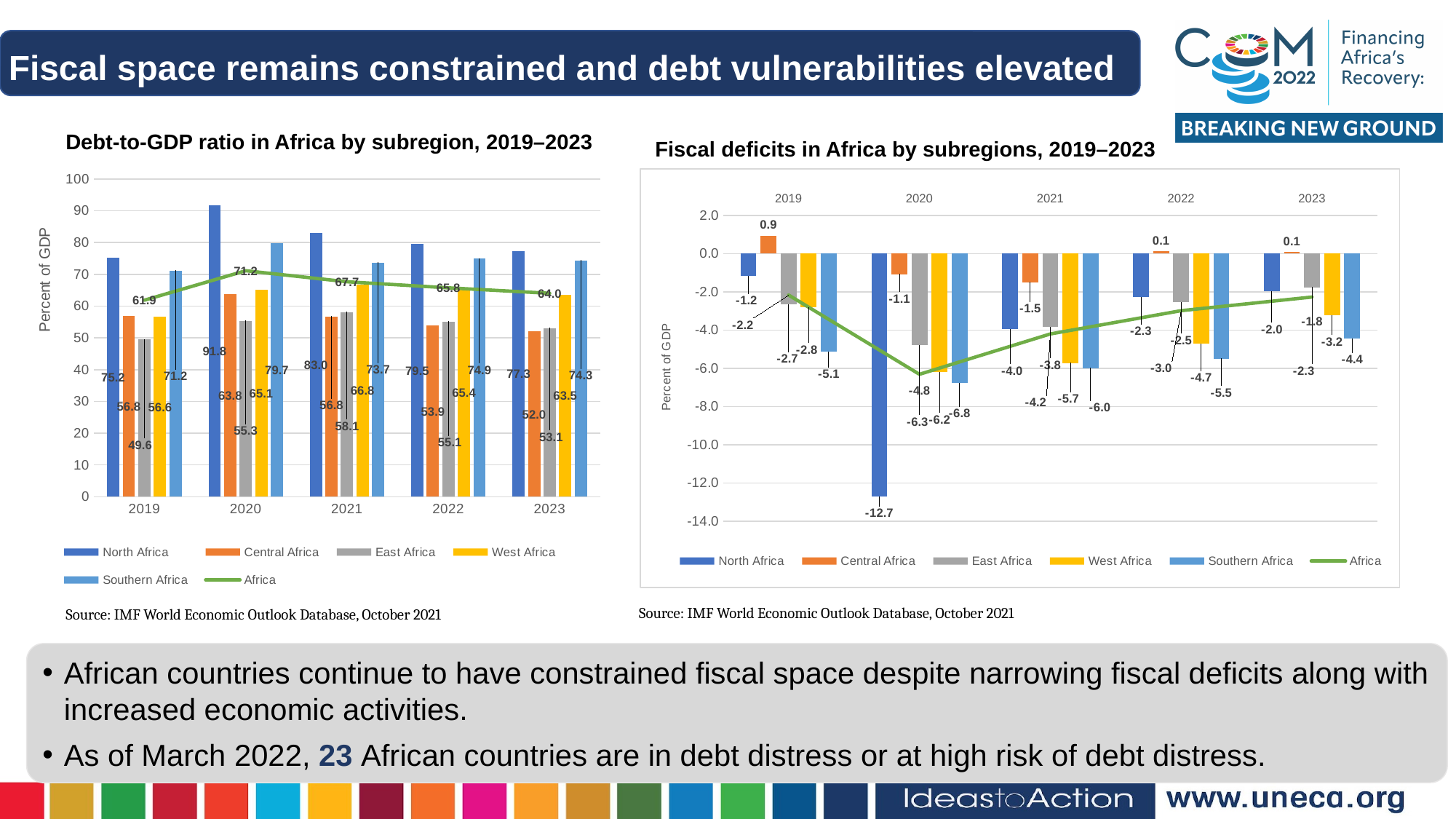
What kind of chart is the 'Fiscal deficits in Africa by subregions' chart? Bar chart with a line In the 'Debt-to-GDP ratio in Africa by subregion' chart, does the Africa line rise or fall from 2020 to 2023? Fall In the 'Debt-to-GDP ratio in Africa by subregion' chart, what is the value of the Africa line in 2023? 64.0 In the 'Debt-to-GDP ratio in Africa by subregion' chart, what is the value for North Africa in 2020? 91.8 In the 'Debt-to-GDP ratio in Africa by subregion' chart, what is the difference between the North Africa and Central Africa values in 2021? 26.2 In the 'Debt-to-GDP ratio in Africa by subregion' chart, how many series does the legend list? 6 In the 'Fiscal deficits in Africa by subregions' chart, how many years are shown on the x axis? 5 In the 'Fiscal deficits in Africa by subregions' chart, which subregion has the largest deficit (lowest value) in 2023? Southern Africa In the 'Debt-to-GDP ratio in Africa by subregion' chart, which subregion has the lowest debt-to-GDP ratio in 2019? East Africa In the 'Fiscal deficits in Africa by subregions' chart, which is larger, the Southern Africa value in 2021 or the Southern Africa value in 2022? 2022 (-5.5) In the 'Fiscal deficits in Africa by subregions' chart, what is the value for Central Africa in 2019? 0.9 In the 'Fiscal deficits in Africa by subregions' chart, what is the value for North Africa in 2020? -12.7